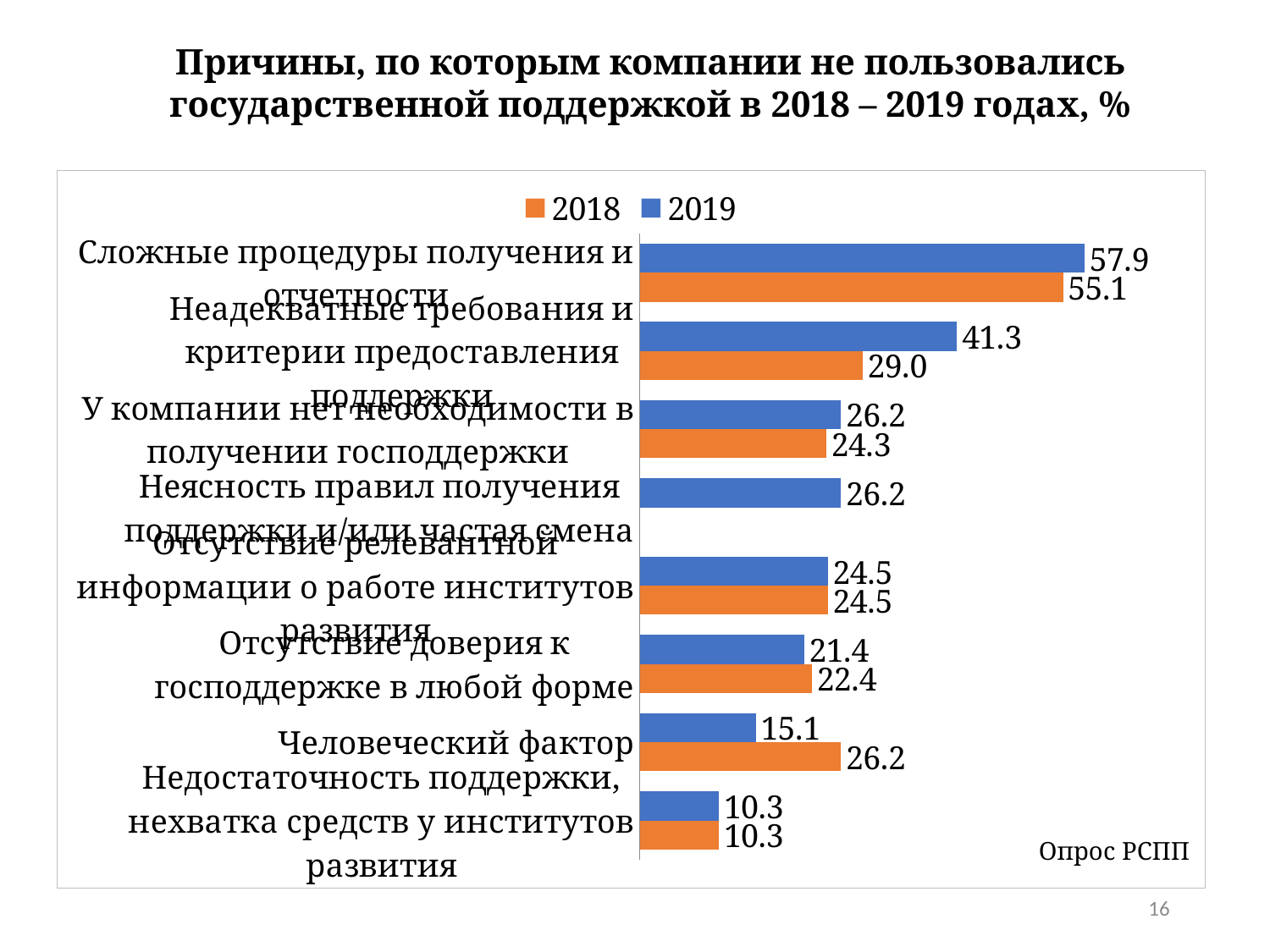
Какое значение за 2018 год у категории «Человеческий фактор»? 26.2 Какая категория имеет наибольшее значение за 2019 год? Сложные процедуры получения и отчетности Сколько категорий показано на диаграмме? 8 Какая категория имеет наименьшее значение за 2018 год? Недостаточность поддержки, нехватка средств у институтов развития Какой тип диаграммы показан на слайде? Столбчатая (bar chart) Какое значение больше у категории «Сложные процедуры получения и отчетности»: за 2018 или за 2019 год? 2019 На сколько значение 2019 года больше значения 2018 года у категории «Неадекватные требования и критерии предоставления поддержки»? 12.3 Какое значение за 2019 год у категории «Сложные процедуры получения и отчетности»? 57.9 Каким цветом на диаграмме обозначен ряд 2019 года? Синим Какое значение за 2018 год у категории «Неадекватные требования и критерии предоставления поддержки»? 29.0 Сколько рядов данных указано в легенде диаграммы? 2 Какое значение больше у категории «Человеческий фактор»: за 2018 или за 2019 год? 2018